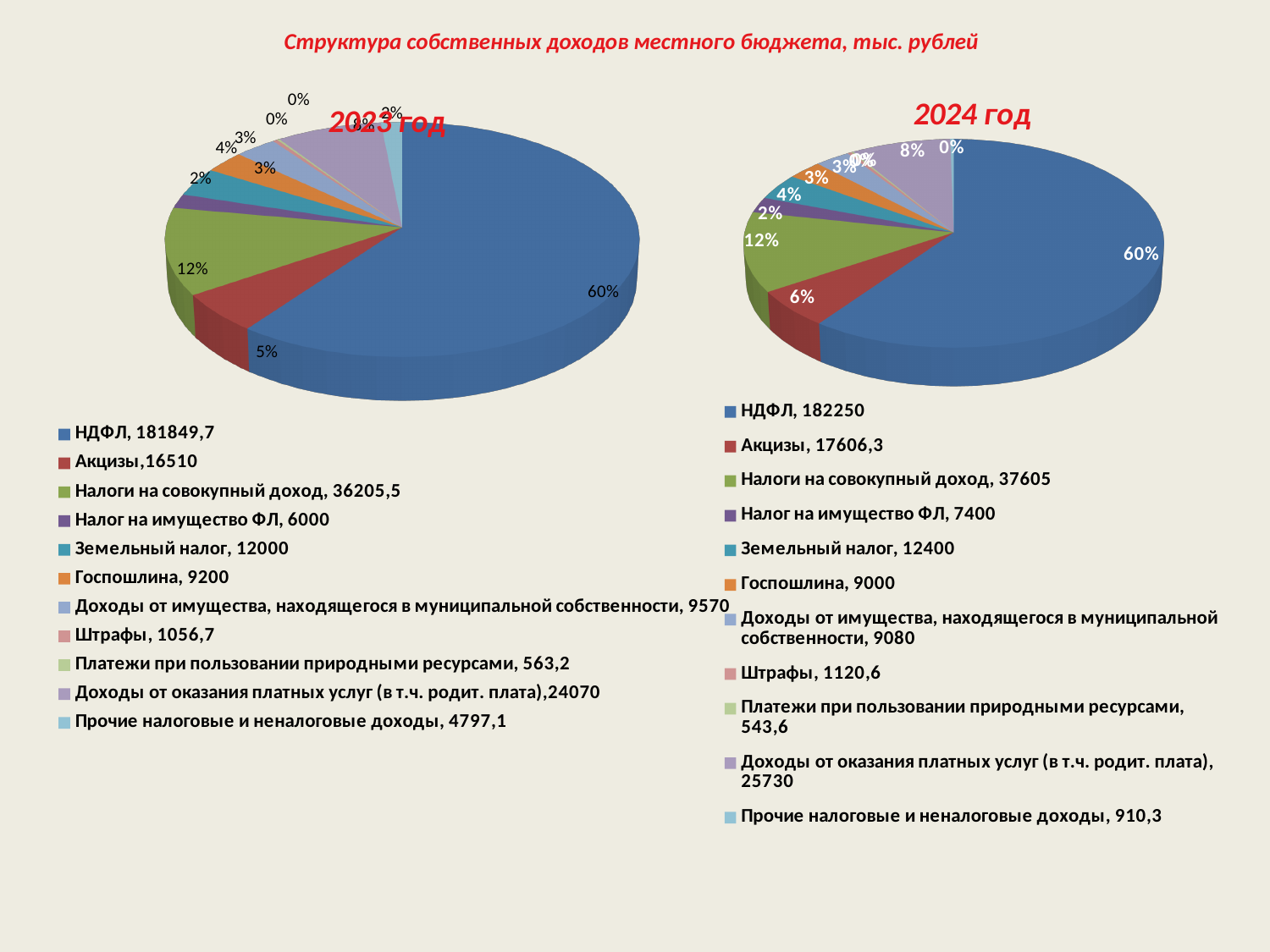
What is the title of the slide above the two charts? Структура собственных доходов местного бюджета, тыс. рублей How many categories does the legend of the 2024 год chart list? 11 In the 2024 год chart, what share of the pie does НДФЛ take? 60% In the 2024 год chart, which category has the largest value? НДФЛ What kind of chart is used for the 2023 год data? pie chart In the 2023 год chart, what value is shown for НДФЛ? 181849,7 In the 2023 год chart, which is larger: Земельный налог or Госпошлина? Земельный налог In the 2024 год chart, what value is shown for Прочие налоговые и неналоговые доходы? 910,3 In the 2024 год chart, what value is shown for Налоги на совокупный доход? 37605 In the 2023 год chart, which category has the smallest value? Платежи при пользовании природными ресурсами What is the difference between Земельный налог in the 2024 год chart and in the 2023 год chart? 400 In the 2023 год chart, what share of the pie does Налоги на совокупный доход take? 12%